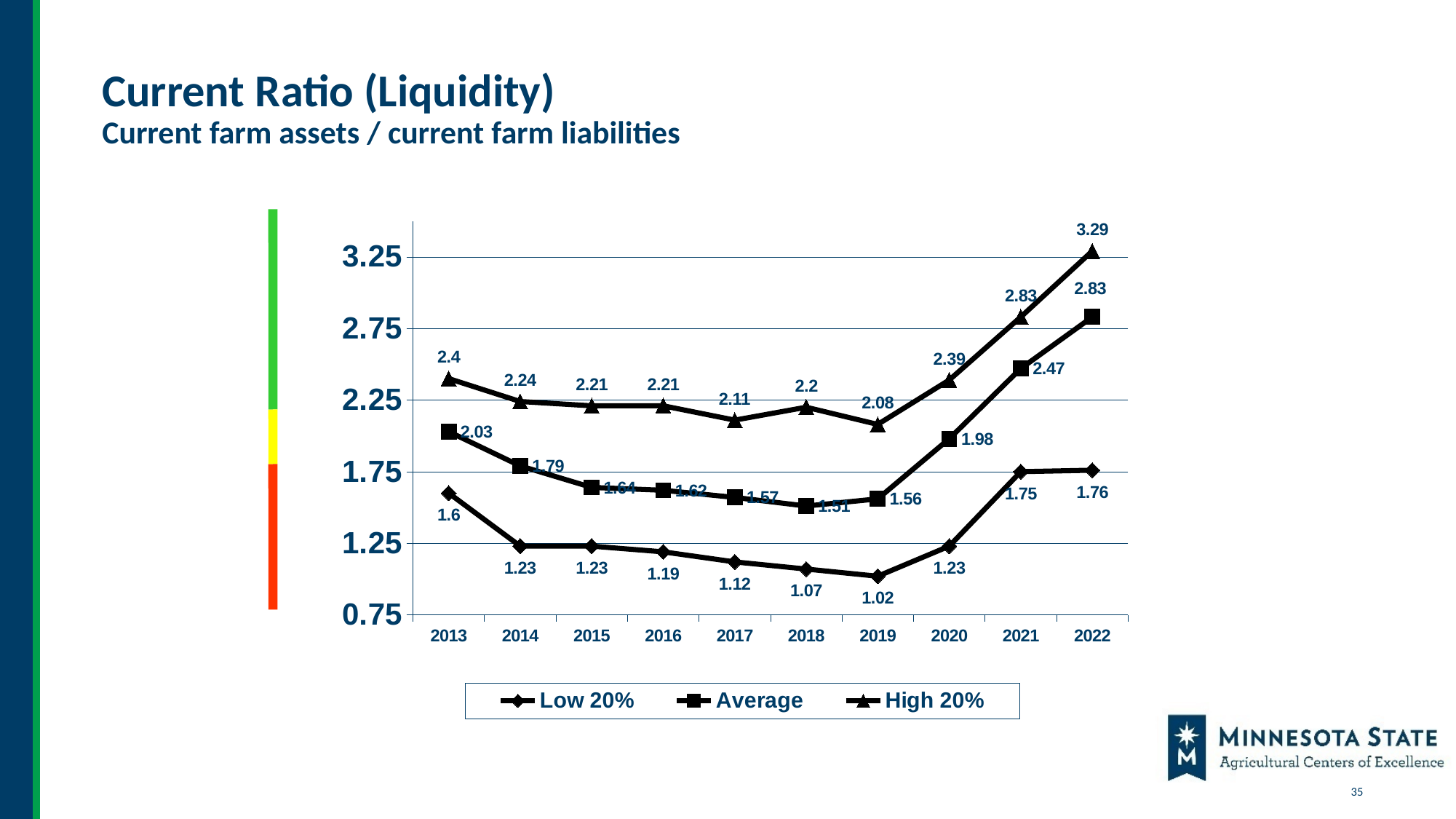
What is the Average value for 2013? 2.03 What is the Low 20% value for 2019? 1.02 What type of chart is shown on the slide? line chart How many series does the legend list? 3 What is the subtitle shown under the chart title 'Current Ratio (Liquidity)'? Current farm assets / current farm liabilities Which is larger: the Average value in 2021 or the High 20% value in 2020? Average value in 2021 In which year is the Low 20% series at its lowest? 2019 What is the difference between the High 20% and Average values in 2022? 0.46 In which year is the High 20% series at its highest? 2022 Does the Average series rise or fall from 2019 to 2022? rise How many years are shown on the x axis? 10 What is the High 20% value for 2022? 3.29